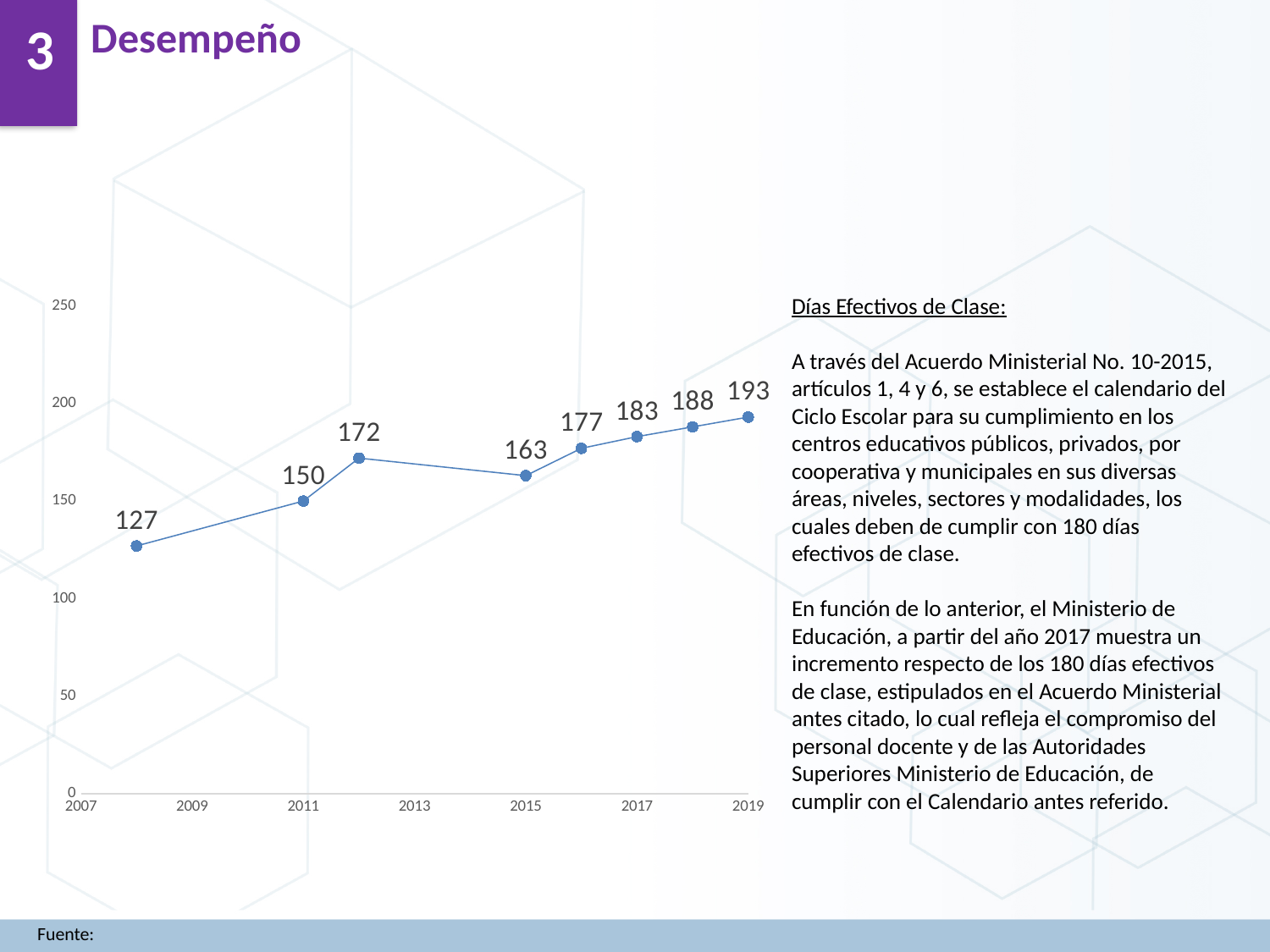
What is the difference between the values for 2019 and 2017? 10 What kind of chart is shown on the slide? line chart Is the value for 2019 greater or less than 150? greater Do the values generally rise or fall from the first point to the last point along the x axis? rise What is the value plotted for 2017? 183 What is the value plotted for 2019? 193 What is the highest value plotted on the chart? 193 What is the value plotted for 2011? 150 What is the lowest value plotted on the chart? 127 What is the value plotted for 2015? 163 How many data points are plotted on the line? 8 Which year has the larger value, 2015 or 2017? 2017